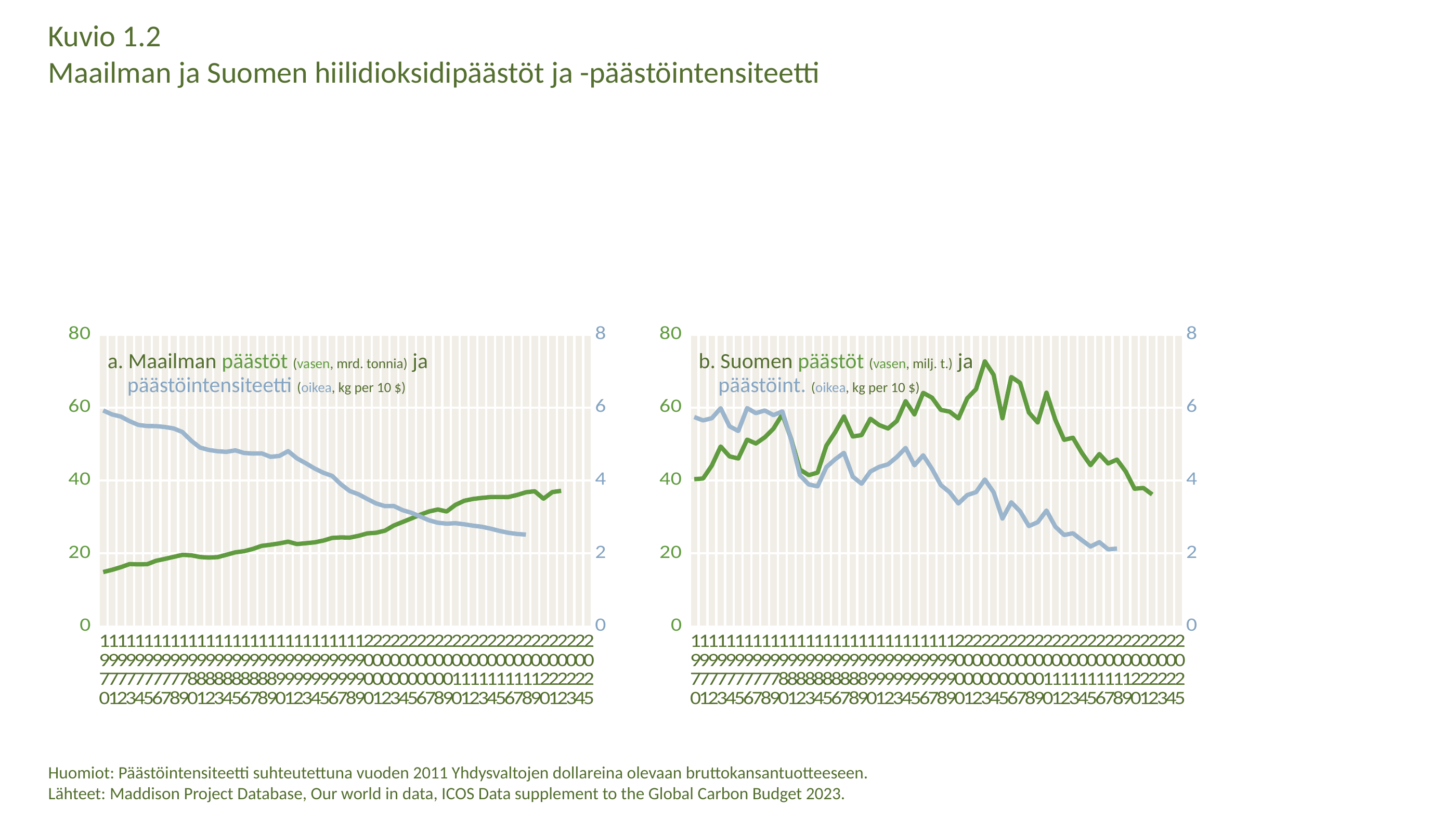
What is the unit given for the world emissions series (päästöt) in the left chart's title? mrd. tonnia In the right chart 'b. Suomen päästöt', is Finland's emissions value in 1970 greater or less than 60? less In the right chart 'b. Suomen päästöt', is the emission intensity value at the end of the blue line greater or less than 4 on the right axis? less What kind of chart is the left chart, 'a. Maailman päästöt'? line chart In the left chart 'a. Maailman päästöt', is the emission intensity value in 1970 greater or less than 4 on the right axis? greater In the left chart 'a. Maailman päästöt', does the blue intensity line (päästöintensiteetti) rise or fall over the period shown? fall What kind of chart is the right chart, 'b. Suomen päästöt'? line chart In the left chart 'a. Maailman päästöt', does the green emissions line (päästöt) rise or fall from 1970 to 2025? rise In the right chart 'b. Suomen päästöt', does the blue intensity line (päästöint.) rise or fall overall from 1970 to the end of the series? fall